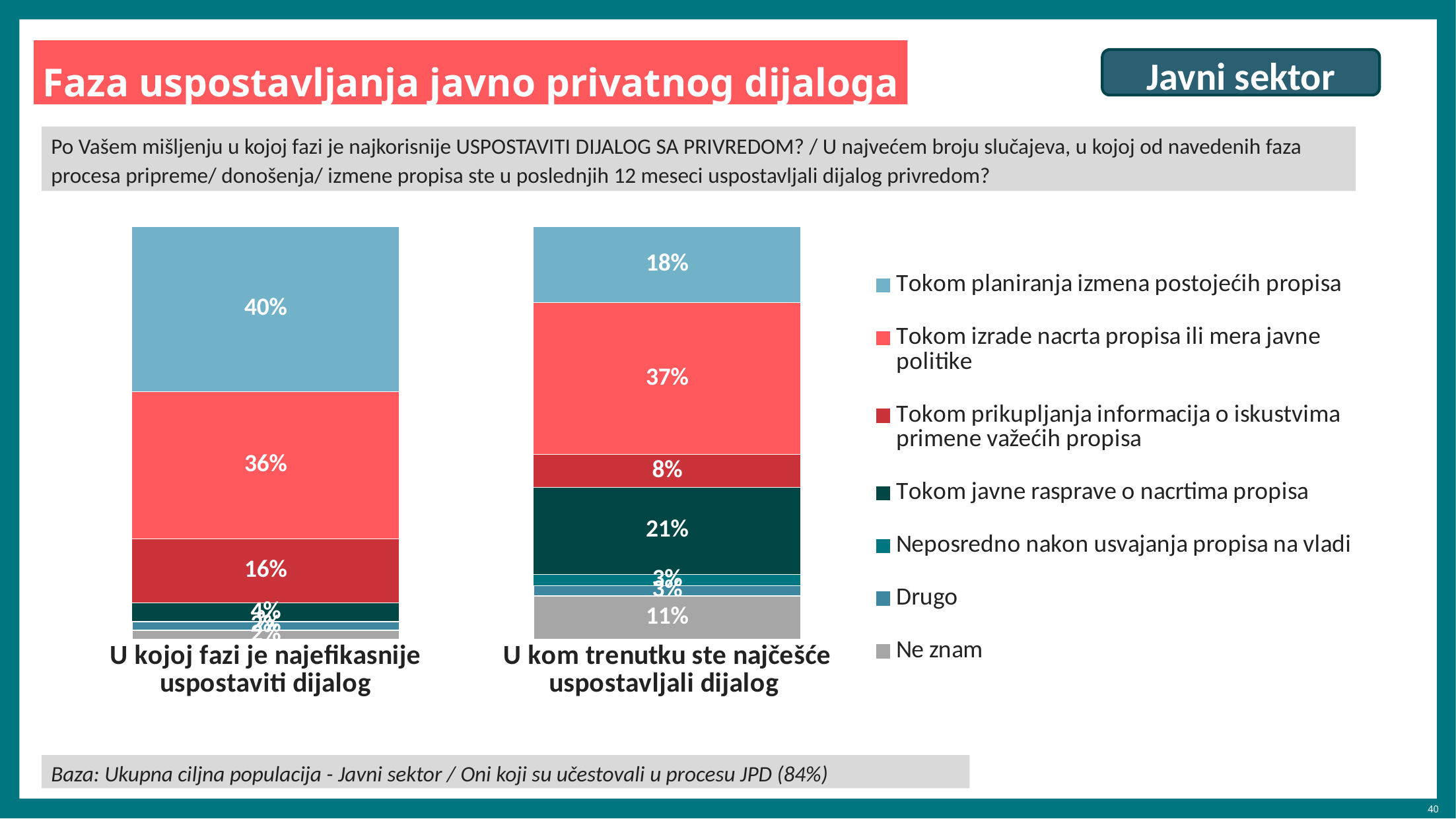
How many bars does the chart contain? 2 In the bar 'U kojoj fazi je najefikasnije uspostaviti dijalog', what is the value for 'Tokom planiranja izmena postojećih propisa'? 40% In the bar 'U kom trenutku ste najčešće uspostavljali dijalog', what is the value for 'Ne znam'? 11% In the bar 'U kom trenutku ste najčešće uspostavljali dijalog', what is the value for 'Tokom prikupljanja informacija o iskustvima primene važećih propisa'? 8% Which bar has the larger value for 'Tokom javne rasprave o nacrtima propisa'? U kom trenutku ste najčešće uspostavljali dijalog In the bar 'U kom trenutku ste najčešće uspostavljali dijalog', what is the value for 'Tokom javne rasprave o nacrtima propisa'? 21% What kind of chart is shown on the slide? Stacked bar chart What is the difference in the 'Tokom planiranja izmena postojećih propisa' value between the bar 'U kojoj fazi je najefikasnije uspostaviti dijalog' and the bar 'U kom trenutku ste najčešće uspostavljali dijalog'? 22 percentage points How many entries does the chart legend list? 7 In the bar 'U kojoj fazi je najefikasnije uspostaviti dijalog', what is the value for 'Tokom prikupljanja informacija o iskustvima primene važećih propisa'? 16% Which category has the largest segment in the bar 'U kom trenutku ste najčešće uspostavljali dijalog'? Tokom izrade nacrta propisa ili mera javne politike In the bar 'U kom trenutku ste najčešće uspostavljali dijalog', what is the value for 'Tokom izrade nacrta propisa ili mera javne politike'? 37%